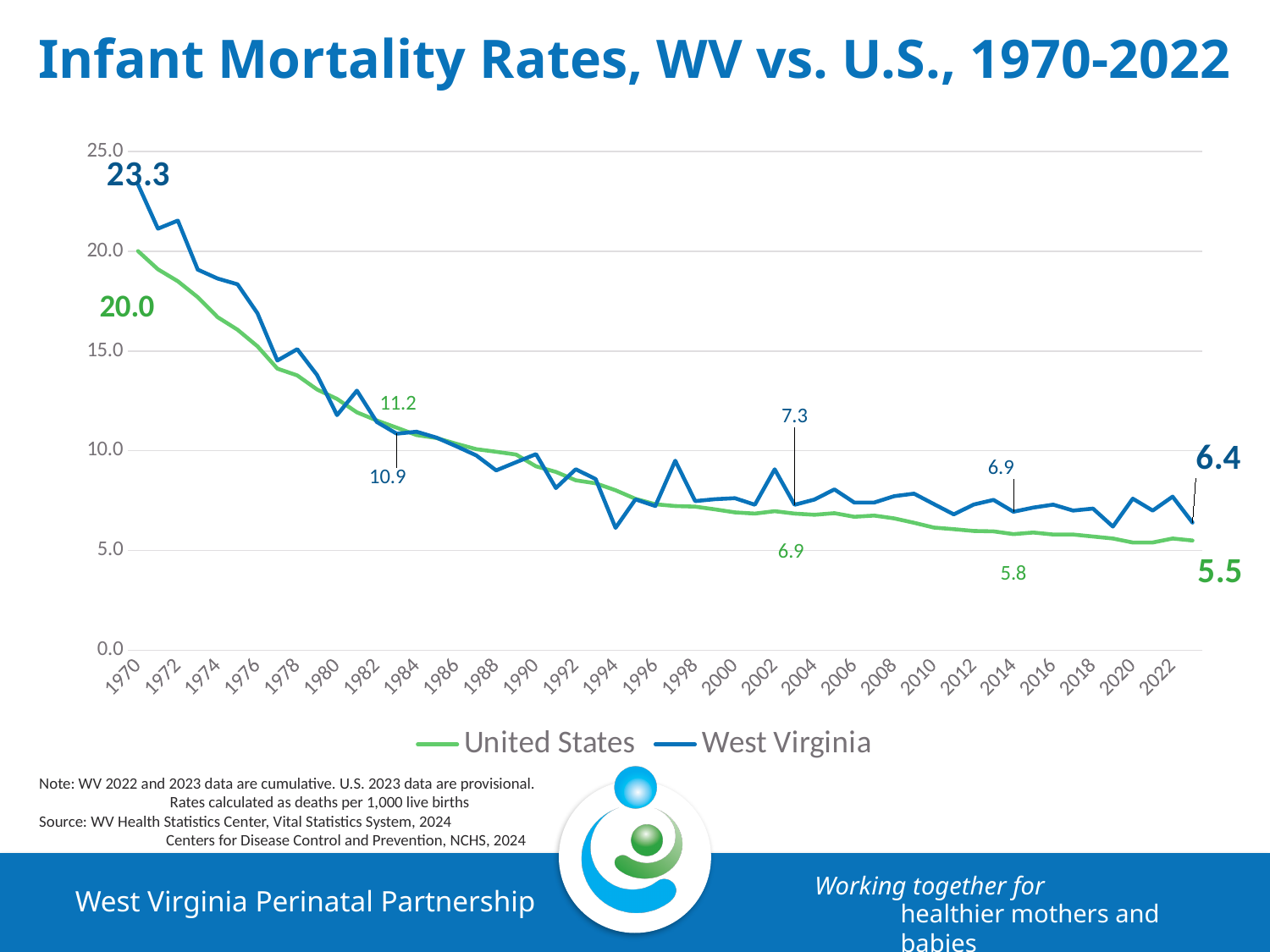
What is the final labeled value for the United States at the right end of the chart? 5.5 What is the difference between the West Virginia and United States rates in 1970? 3.3 What is the final labeled value for West Virginia at the right end of the chart? 6.4 What type of chart is shown on the slide? line chart Which series is drawn in green? United States Is the West Virginia value in 1994 greater or less than 10.0? less How many series does the legend list? 2 What was the West Virginia infant mortality rate in 1970? 23.3 What was the United States infant mortality rate in 1970? 20.0 What is the difference between the final labeled West Virginia value (6.4) and the final labeled United States value (5.5)? 0.9 Which series had the higher rate in 1970, West Virginia or the United States? West Virginia Do the infant mortality rates generally rise or fall from 1970 to 2022? fall